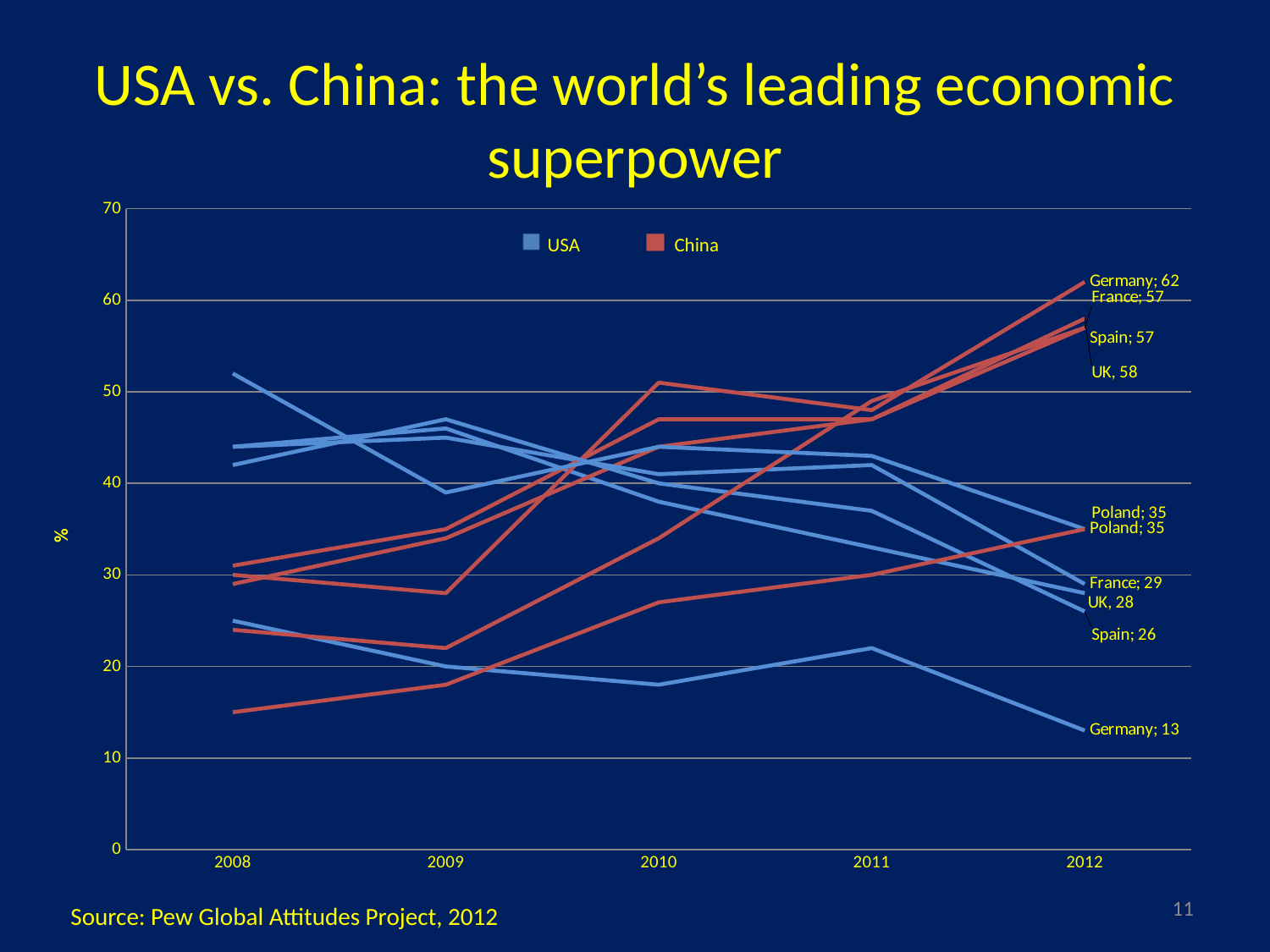
Does the China line for Germany rise or fall from 2008 to 2012? rise Which labelled 2012 value is the highest on the chart? Germany; 62 How many series does the legend list? 2 Which colour represents the China series in the legend? red What is the 2012 value for the UK in the China series? 58 What is the 2012 value for Germany in the USA series? 13 Which labelled 2012 value is the lowest on the chart? Germany; 13 What kind of chart is shown on the slide? line chart For France in 2012, which is larger: the USA value or the China value? China How many years are shown on the x axis? 5 What is the 2012 value for Germany in the China series? 62 What is the difference between the 2012 China value and the 2012 USA value for Germany? 49